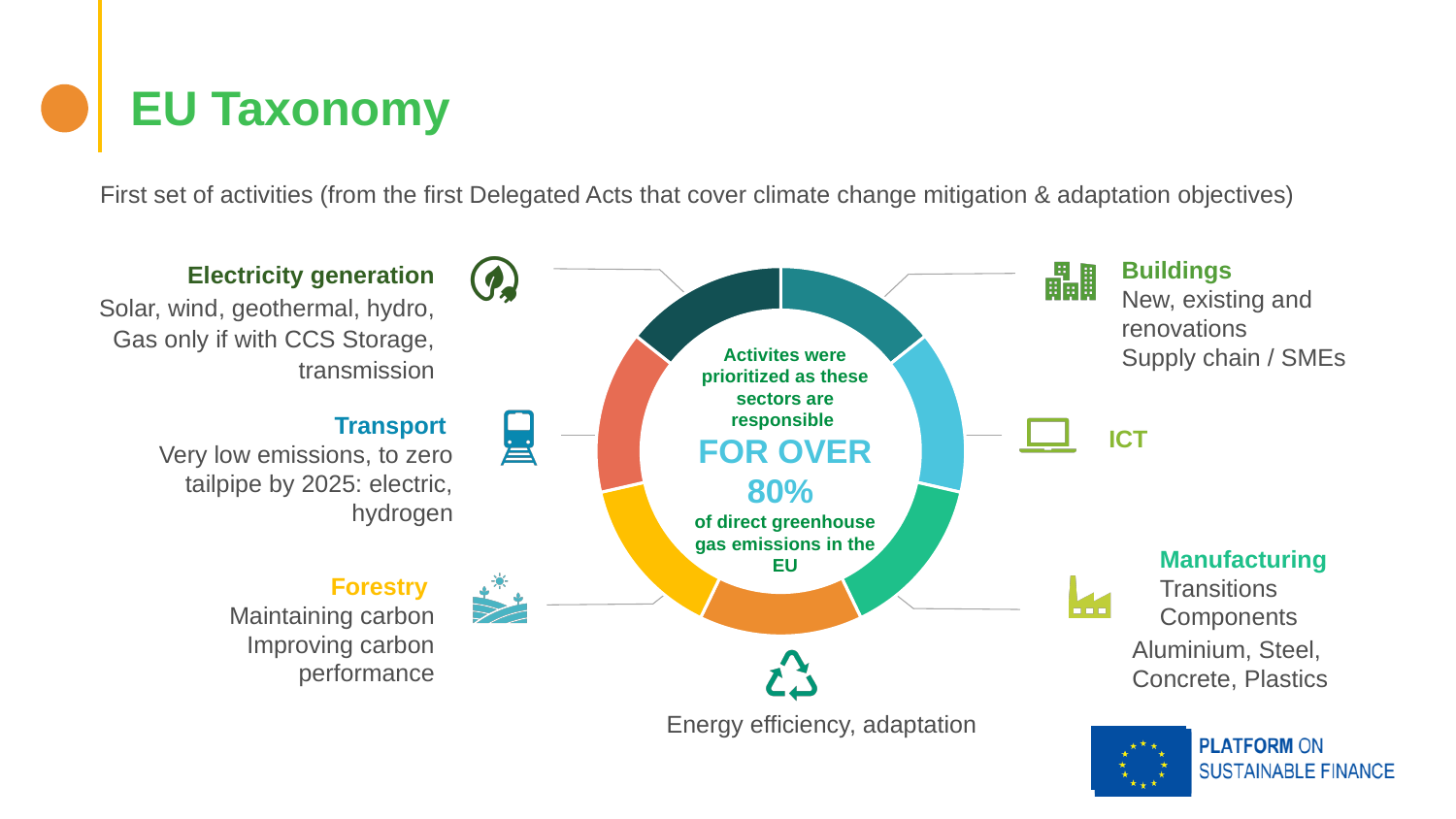
What kind of chart is shown in the centre of the slide? Pie (donut) chart How many segments does the donut chart have? 7 Which sector is linked to the yellow segment of the donut chart? Forestry Which sector is linked to the light blue segment on the right of the donut chart? ICT According to the text in the centre of the donut chart, what share of direct greenhouse gas emissions in the EU are the prioritised sectors responsible for? Over 80%